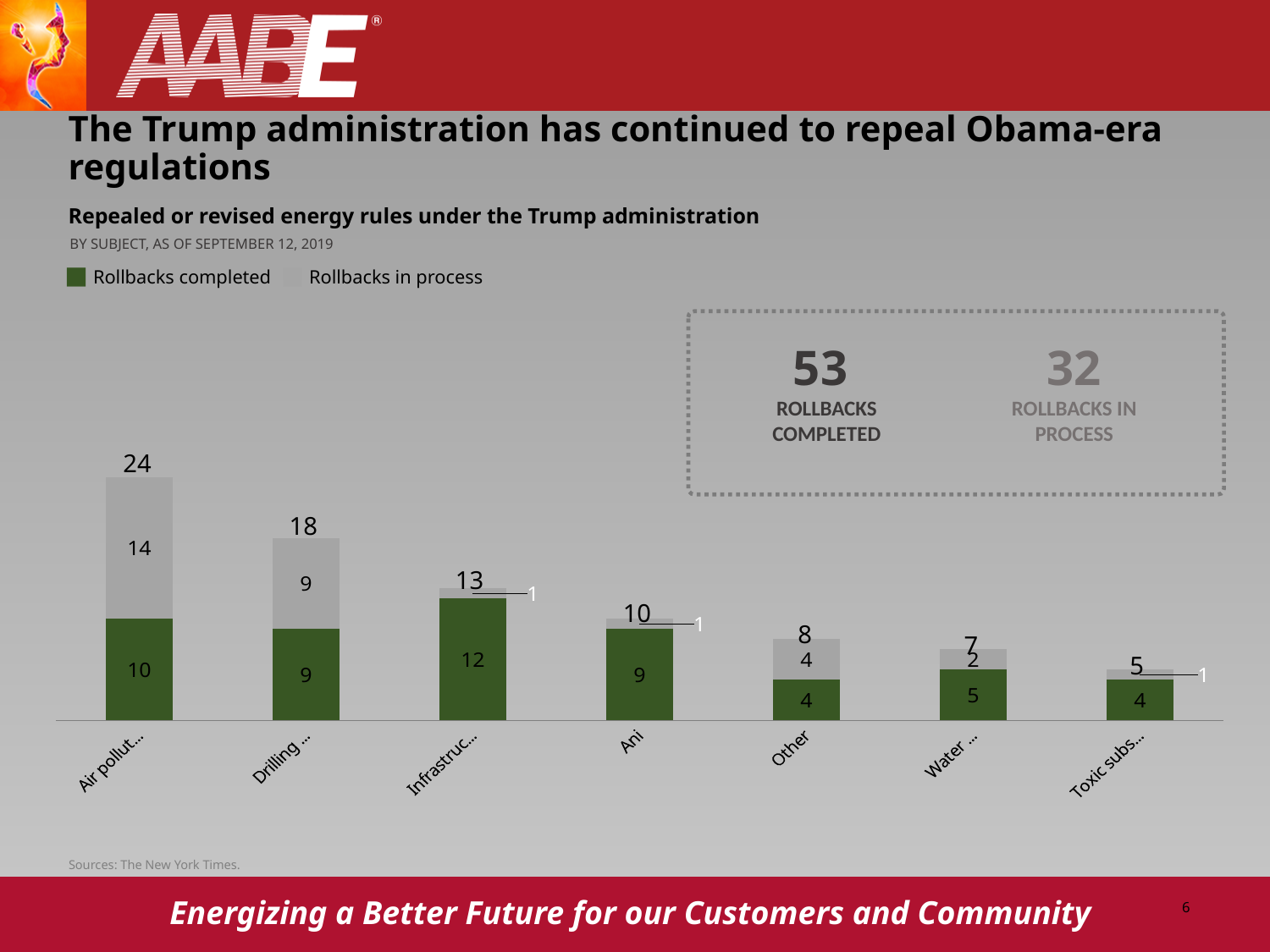
Do the bar totals rise or fall from left to right across the chart? Fall For the first bar (Air pollut...), which is larger: Rollbacks completed or Rollbacks in process? Rollbacks in process What is the value of Rollbacks completed for the Other category? 4 What is the value of Rollbacks in process for the first bar (Air pollut...)? 14 According to the summary box on the slide, how many rollbacks are in process in total? 32 Which category has the highest total in the chart? Air pollut... (the first bar) How many series does the chart legend list? 2 How many categories (bars) are plotted in the chart? 7 Which category has the lowest total in the chart? Toxic subs... (the last bar) What is the difference between the Rollbacks completed value for the first bar (Air pollut...) and for Other? 6 What is the total of the first stacked bar (Air pollut...)? 24 What kind of chart is shown on the slide? Stacked bar chart